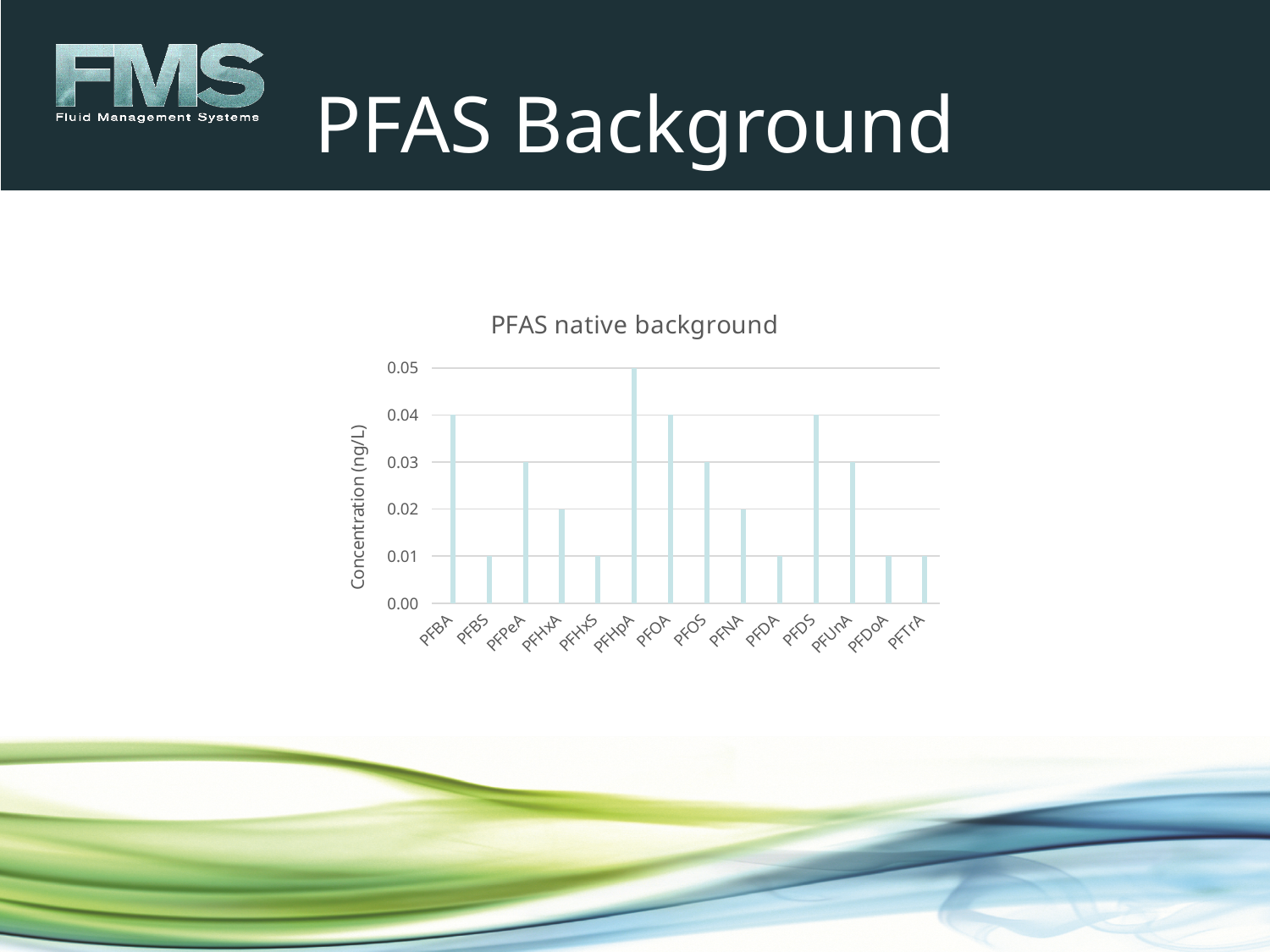
What is the title of the chart? PFAS native background What is the label of the vertical axis? Concentration (ng/L) Which is larger, the value for PFOA or the value for PFOS? PFOA What is the concentration for PFHpA? 0.05 What is the concentration for PFUnA? 0.03 Which category has the highest concentration? PFHpA What is the difference between the values for PFHpA and PFDS? 0.01 How many categories are plotted on the x axis? 14 What type of chart is shown on the slide? Bar chart What is the concentration for PFHxA? 0.02 Is the value for PFPeA greater or less than 0.02? greater What is the concentration for PFBA? 0.04